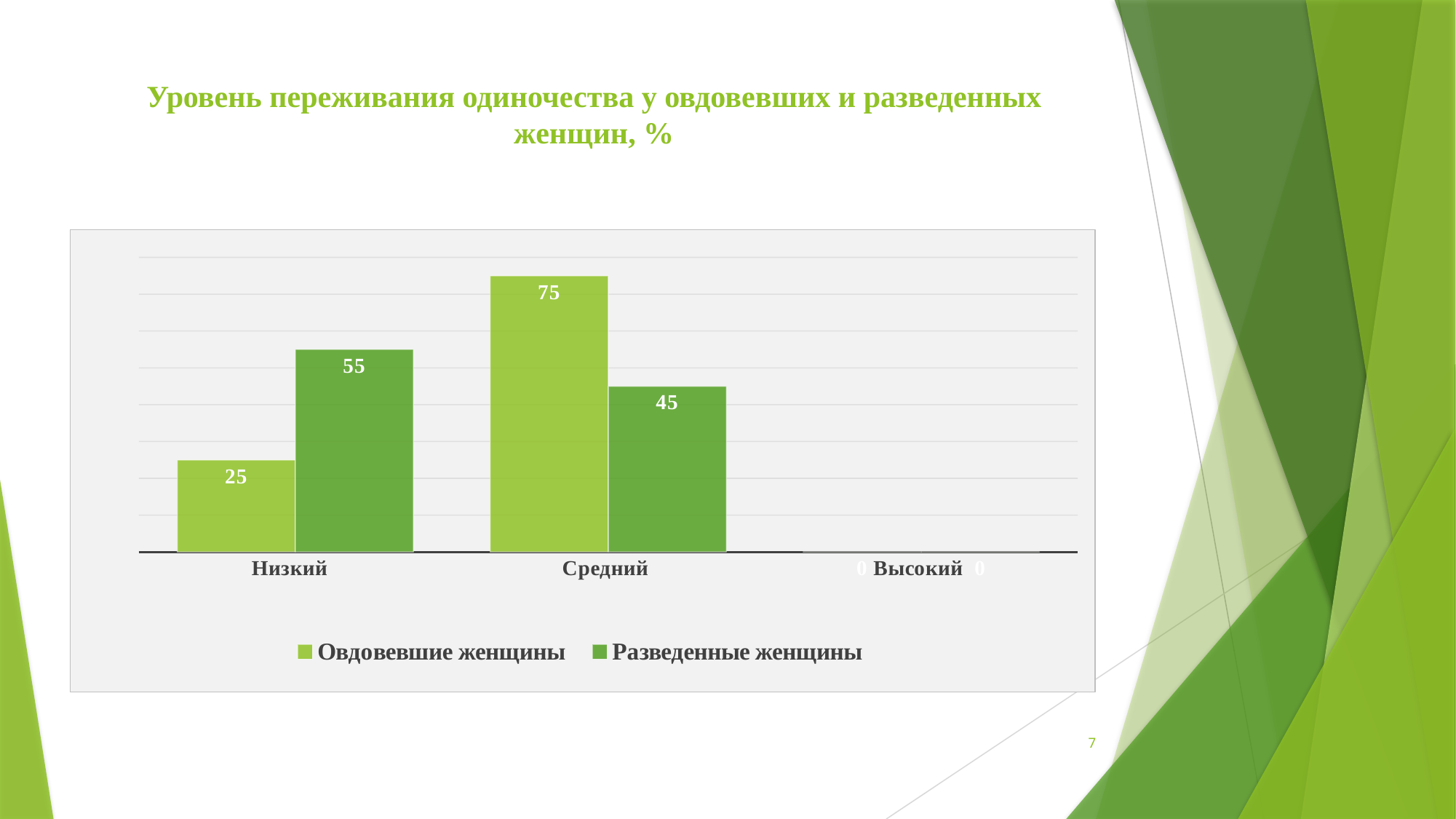
What is the difference between Овдовевшие женщины and Разведенные женщины at the Средний level? 30 How many series does the legend list? 2 What is the value for Овдовевшие женщины at the Высокий level? 0 What is the value for Овдовевшие женщины at the Средний level? 75 Which level has the highest value for Овдовевшие женщины? Средний What is the value for Овдовевшие женщины at the Низкий level? 25 What kind of chart is shown on the slide? Bar chart How many levels are shown on the x axis? 3 At the Низкий level, which series has the larger value: Овдовевшие женщины or Разведенные женщины? Разведенные женщины What is the value for Разведенные женщины at the Низкий level? 55 Which level has the lowest value for Разведенные женщины? Высокий What is the value for Разведенные женщины at the Средний level? 45